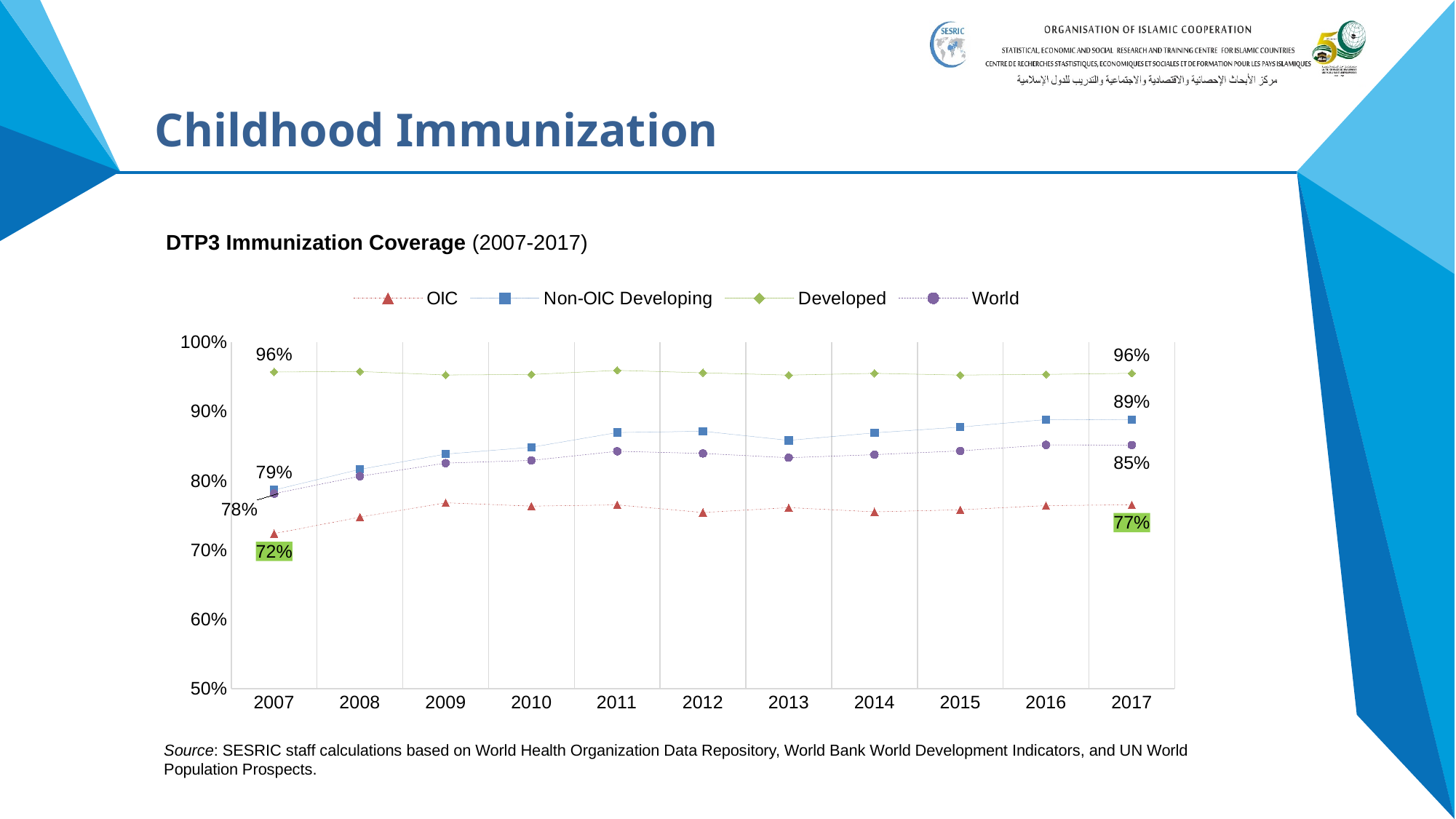
What kind of chart is shown on the slide? line chart By how many percentage points did OIC DTP3 immunization coverage change from 2007 to 2017? 5 percentage points How many series does the legend list? 4 What was the DTP3 immunization coverage for OIC in 2007? 72% What was the DTP3 immunization coverage for OIC in 2017? 77% How many years are shown on the x axis of the chart? 11 Which series had the highest DTP3 immunization coverage in 2017? Developed What was the DTP3 immunization coverage for Developed countries in 2017? 96% What was the DTP3 immunization coverage for the World in 2007? 78% What is the difference between Non-OIC Developing and OIC DTP3 coverage in 2017? 12 percentage points Which series had the lowest DTP3 immunization coverage in 2007? OIC What was the DTP3 immunization coverage for Non-OIC Developing countries in 2017? 89%